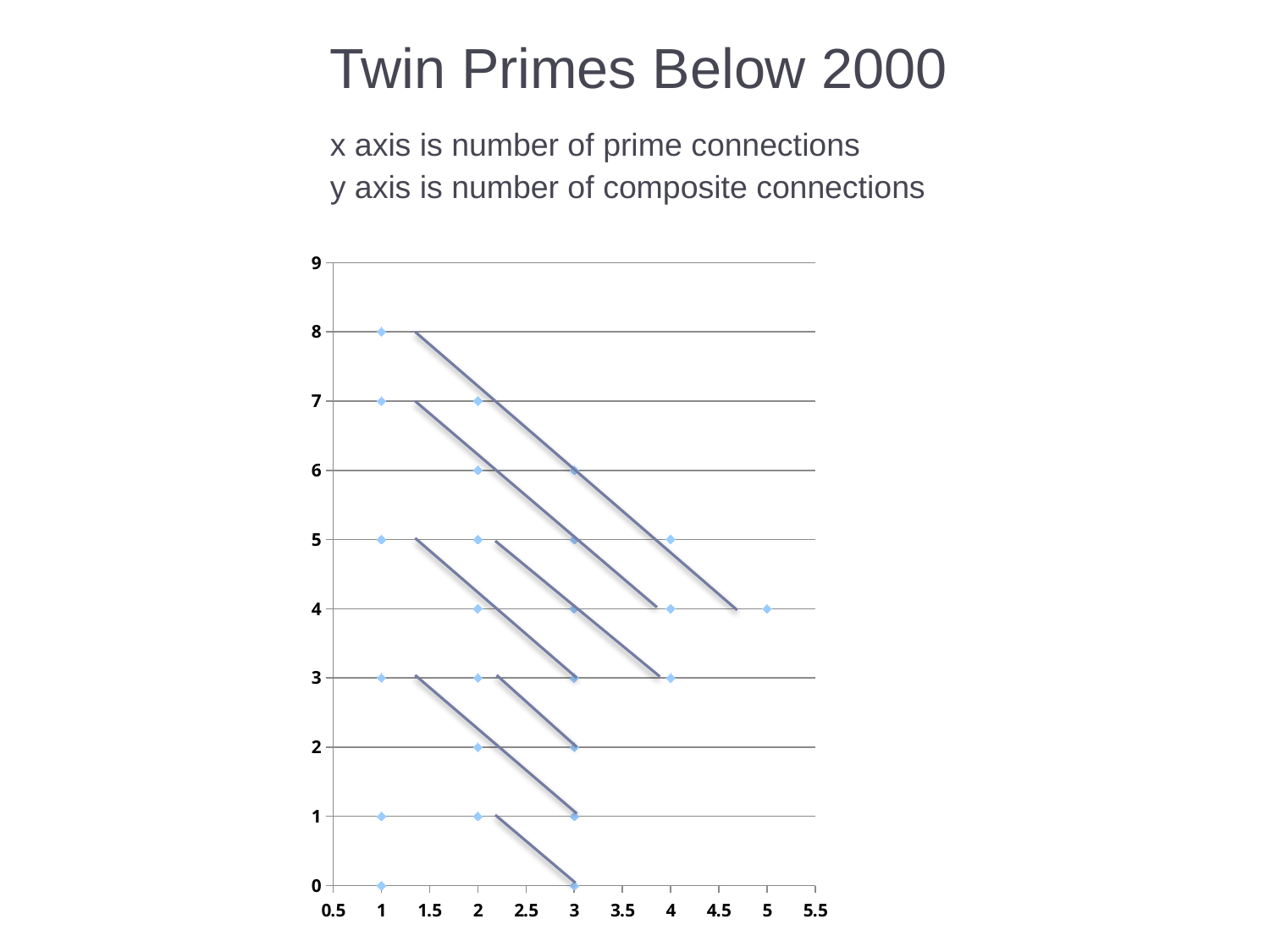
What is the lowest y value among the points at x = 4? 3 What is the y value of the point plotted at x = 5? 4 What is the highest y value among the points at x = 4? 5 What is the highest tick label shown on the y axis? 9 Which x value has more plotted points, x = 2 or x = 5? x = 2 According to the slide, what does the y axis represent? number of composite connections What is the highest y value plotted on the chart? 8 What is the difference between the highest y value at x = 1 and the highest y value at x = 4? 3 What is the largest x value at which a point is plotted? 5 How many points are plotted at x = 4? 3 What is the title of the chart? Twin Primes Below 2000 What kind of chart is shown on the slide? scatter chart